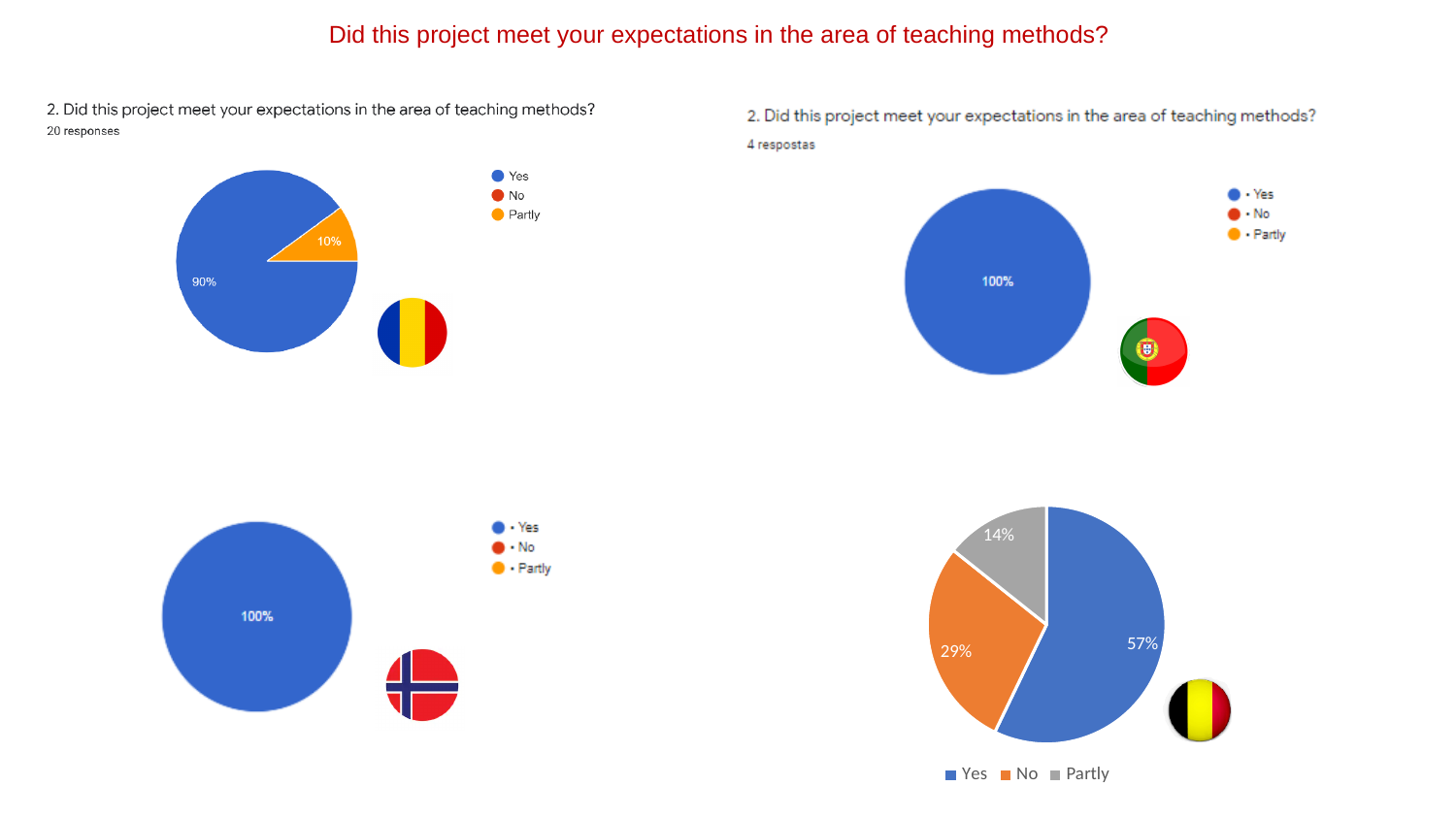
How many responses does the top-left chart report? 20 responses In the bottom-right pie chart, what percentage of responses is Yes? 57% What kind of chart is used in the bottom-right of the slide? Pie chart In the top-left pie chart, what percentage of responses is Partly? 10% In the bottom-right pie chart, which category has the largest slice? Yes In the top-right pie chart, what percentage of responses is Yes? 100% How many responses does the top-right chart report? 4 respostas In the top-left pie chart, what share of responses is labelled 90%? Yes In the bottom-right pie chart, what percentage of responses is No? 29% In the bottom-right pie chart, what percentage of responses is Partly? 14% In the bottom-right pie chart, what is the difference between the Yes and No shares? 28% In the bottom-left pie chart, what percentage is shown on the pie? 100%